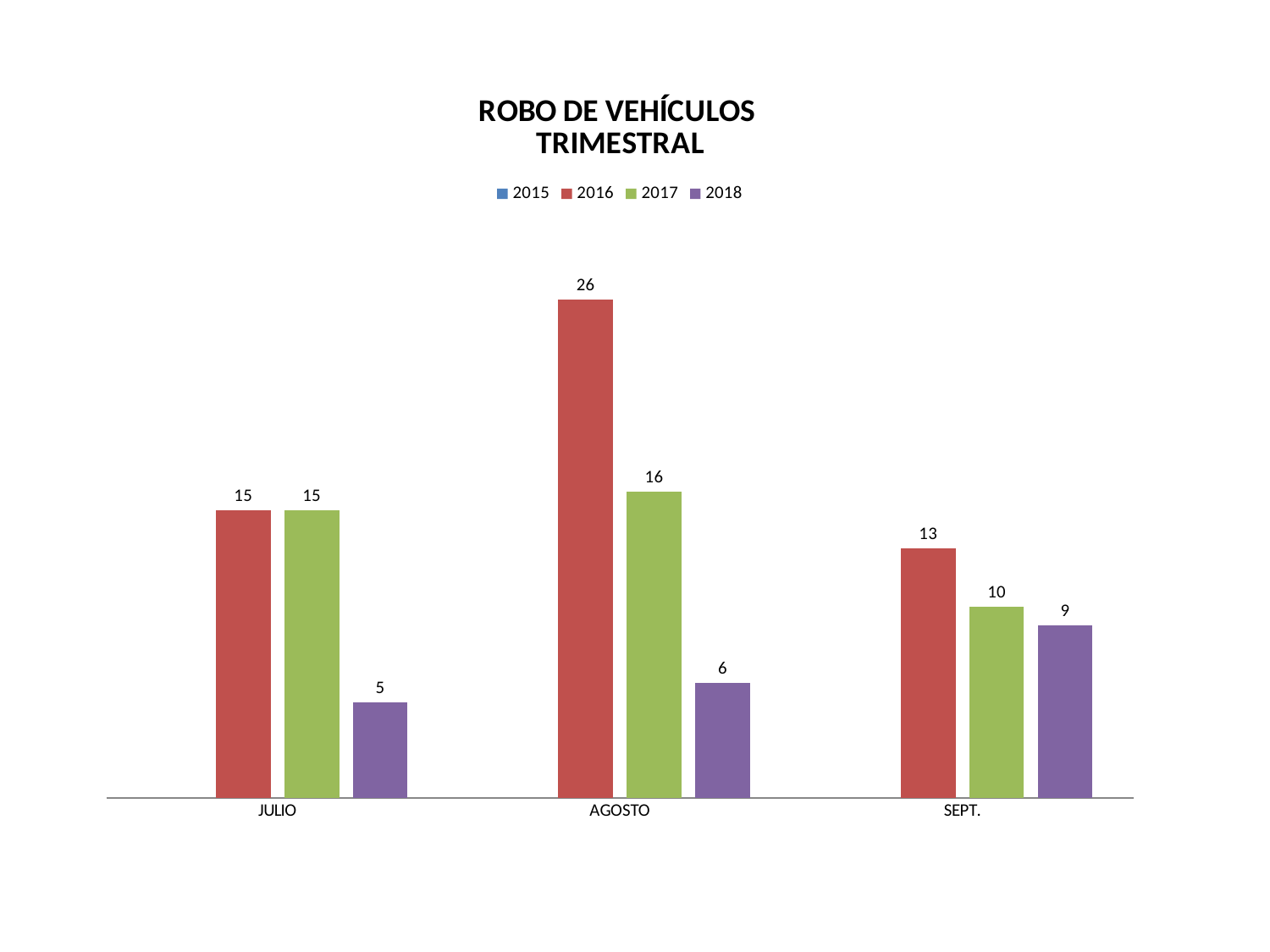
Which is larger in SEPT., the 2016 value or the 2018 value? 2016 What is the difference between the 2016 and 2017 values in AGOSTO? 10 In which month is the 2018 value lowest? JULIO What is the title of the chart? ROBO DE VEHÍCULOS TRIMESTRAL In which month is the 2016 value highest? AGOSTO How many months are shown on the x axis? 3 How many series does the legend list? 4 What kind of chart is this? bar chart What is the value for 2017 in SEPT.? 10 What is the value for 2016 in AGOSTO? 26 What is the value for 2018 in JULIO? 5 What is the value for 2018 in SEPT.? 9